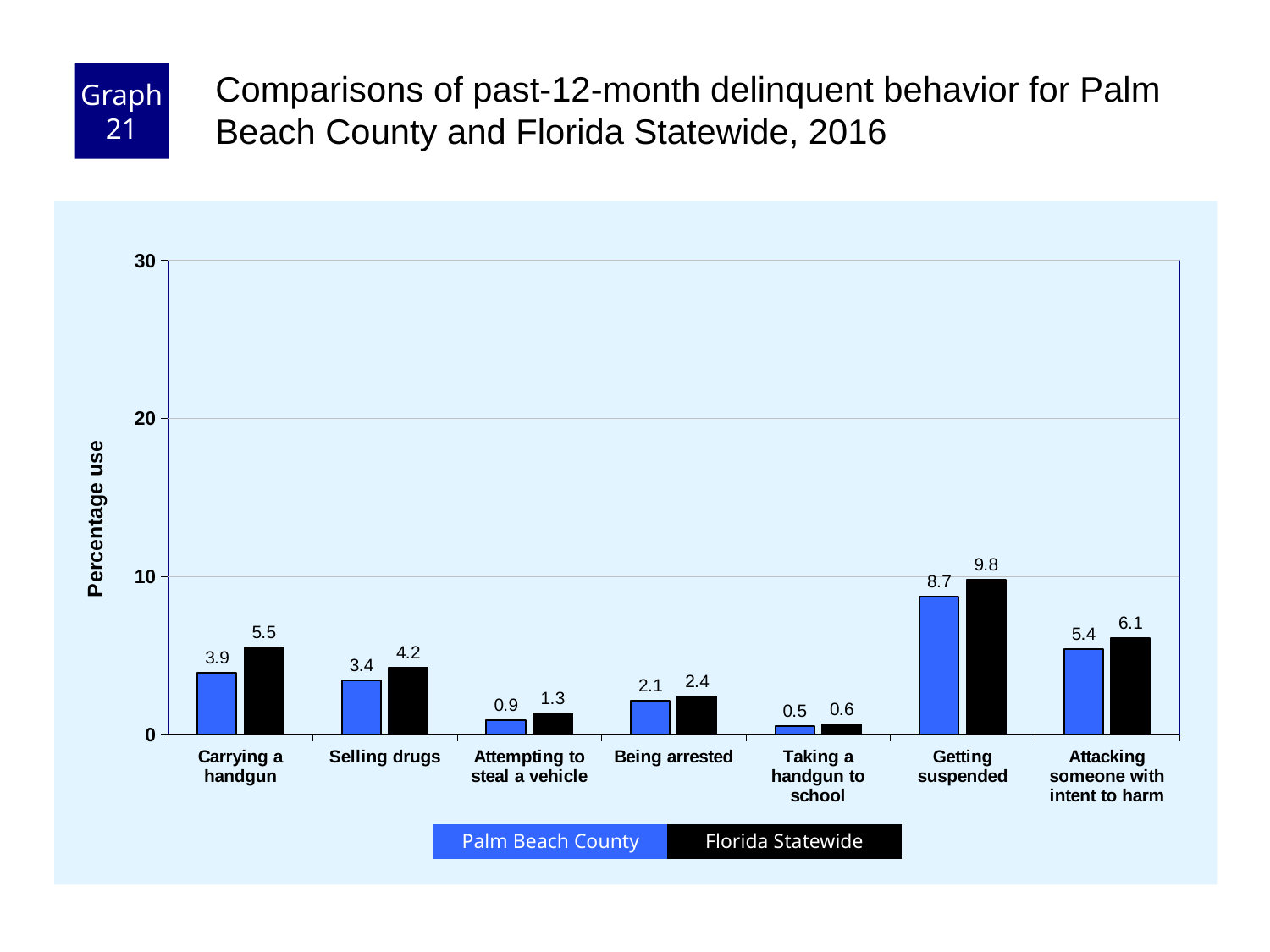
What kind of chart is shown on the slide? bar chart How many series does the legend list? 2 What is the label of the y axis? Percentage use What is the Palm Beach County value for Taking a handgun to school? 0.5 What is the difference between the Florida Statewide and Palm Beach County values for Carrying a handgun? 1.6 Which category has the lowest Palm Beach County value? Taking a handgun to school Which is larger for Selling drugs: Palm Beach County or Florida Statewide? Florida Statewide How many categories are shown on the x axis? 7 What is the Florida Statewide value for Carrying a handgun? 5.5 Is the Florida Statewide value for Getting suspended greater or less than 10? less What is the Palm Beach County value for Getting suspended? 8.7 Which category has the highest Florida Statewide value? Getting suspended